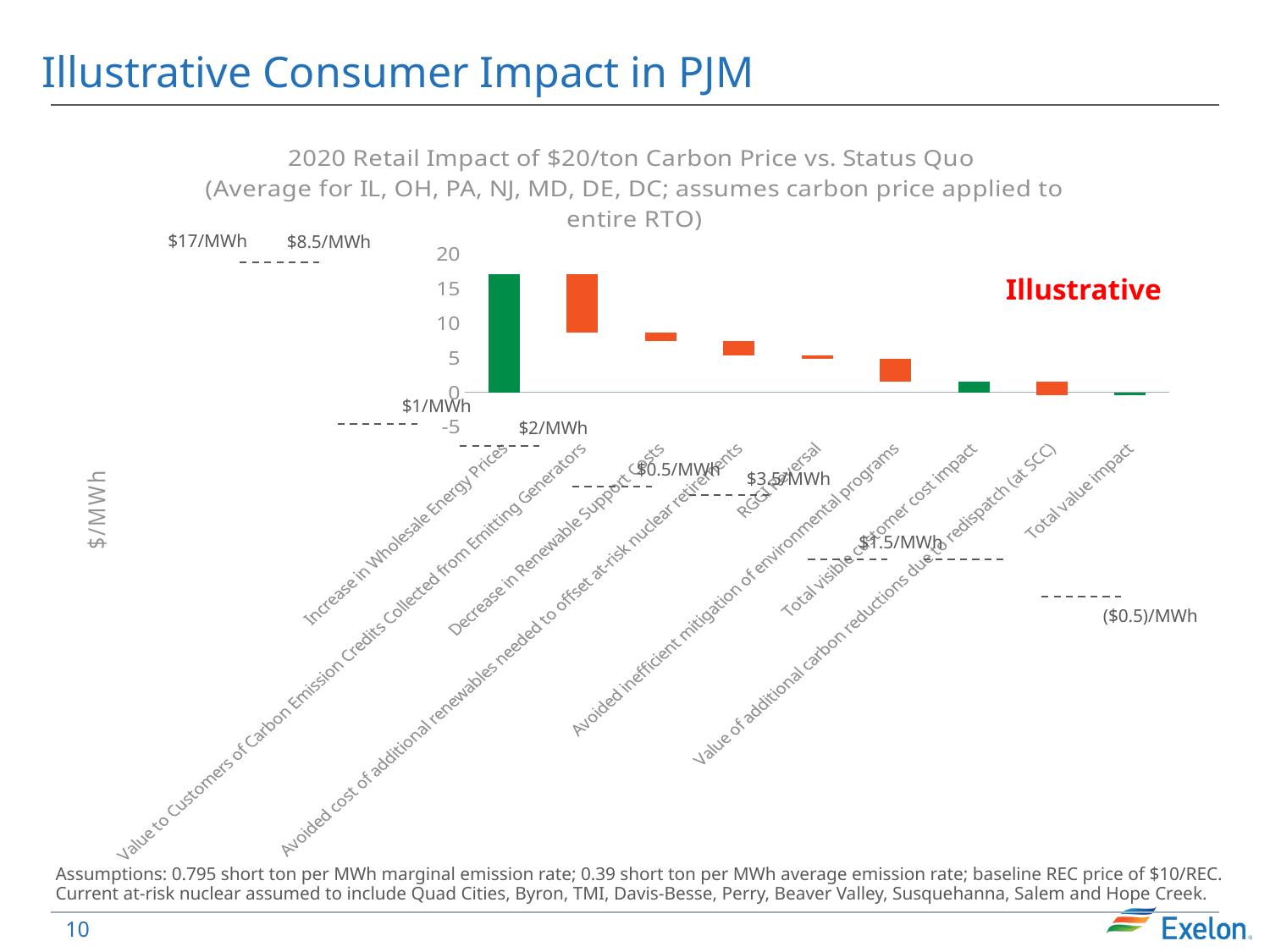
What is the value labelled for 'Avoided inefficient mitigation of environmental programs'? $3.5/MWh What is the value labelled for 'Value to Customers of Carbon Emission Credits Collected from Emitting Generators'? $8.5/MWh What is the value labelled for 'Increase in Wholesale Energy Prices'? $17/MWh What is the label on the vertical axis of the chart? $/MWh What is the value labelled for 'Decrease in Renewable Support Costs'? $1/MWh Which category has the largest bar in the chart? Increase in Wholesale Energy Prices Which is larger: the labelled value for 'Avoided inefficient mitigation of environmental programs' or for 'Avoided cost of additional renewables needed to offset at-risk nuclear retirements'? Avoided inefficient mitigation of environmental programs Is the bar for 'Increase in Wholesale Energy Prices' greater or less than 15 on the axis? greater What is the difference between the labelled values for 'Increase in Wholesale Energy Prices' and 'Value to Customers of Carbon Emission Credits Collected from Emitting Generators'? $8.5/MWh How many categories are shown on the x axis of the chart? 9 What kind of chart is shown on the slide? bar chart What is the value labelled for 'Total value impact'? ($0.5)/MWh